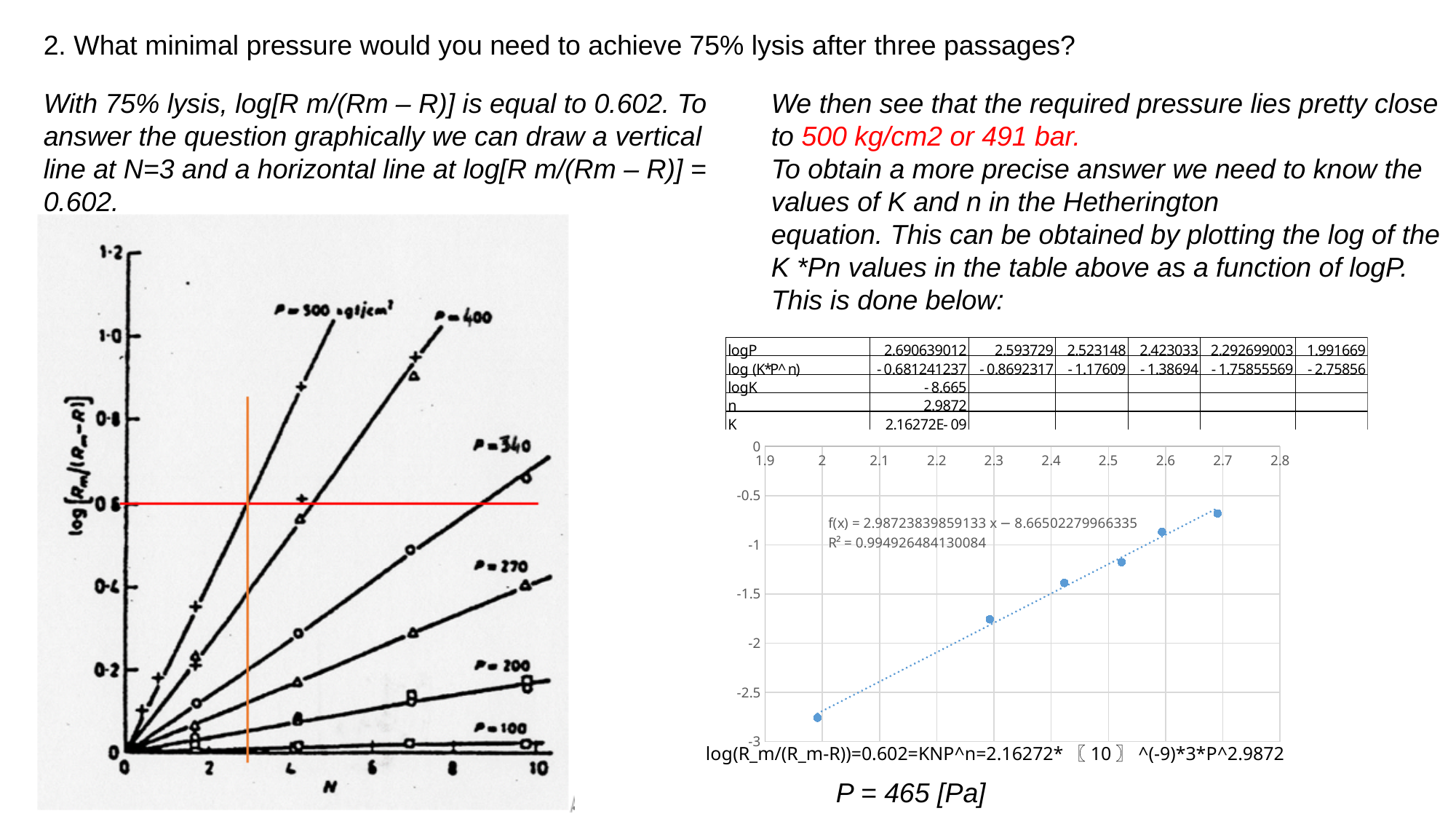
On the right-hand scatter chart, is the value of the point at logP of about 2 greater or less than -2.5? less On the left chart, do the values of log[Rm/(Rm-R)] rise or fall as N increases? rise On the left chart, which pressure line rises most steeply with N? P=500 What R² value is shown for the trendline on the right-hand scatter chart? 0.994926484130084 How many data points are plotted on the right-hand scatter chart? 6 What kind of chart is the scanned chart on the left of the slide? line chart How many pressure lines (P values) are plotted on the left chart? 6 On the left chart, which pressure line is the lowest (flattest)? P=100 On the left chart, is the value of the P=340 line at N=10 greater or less than 0.6? greater On the left chart, at what value of log[Rm/(Rm-R)] is the horizontal red line drawn? 0.602 On the left chart, is the value of the P=100 line at N=10 greater or less than 0.2? less What kind of chart is the chart on the right of the slide (log(K*P^n) versus logP)? scatter chart